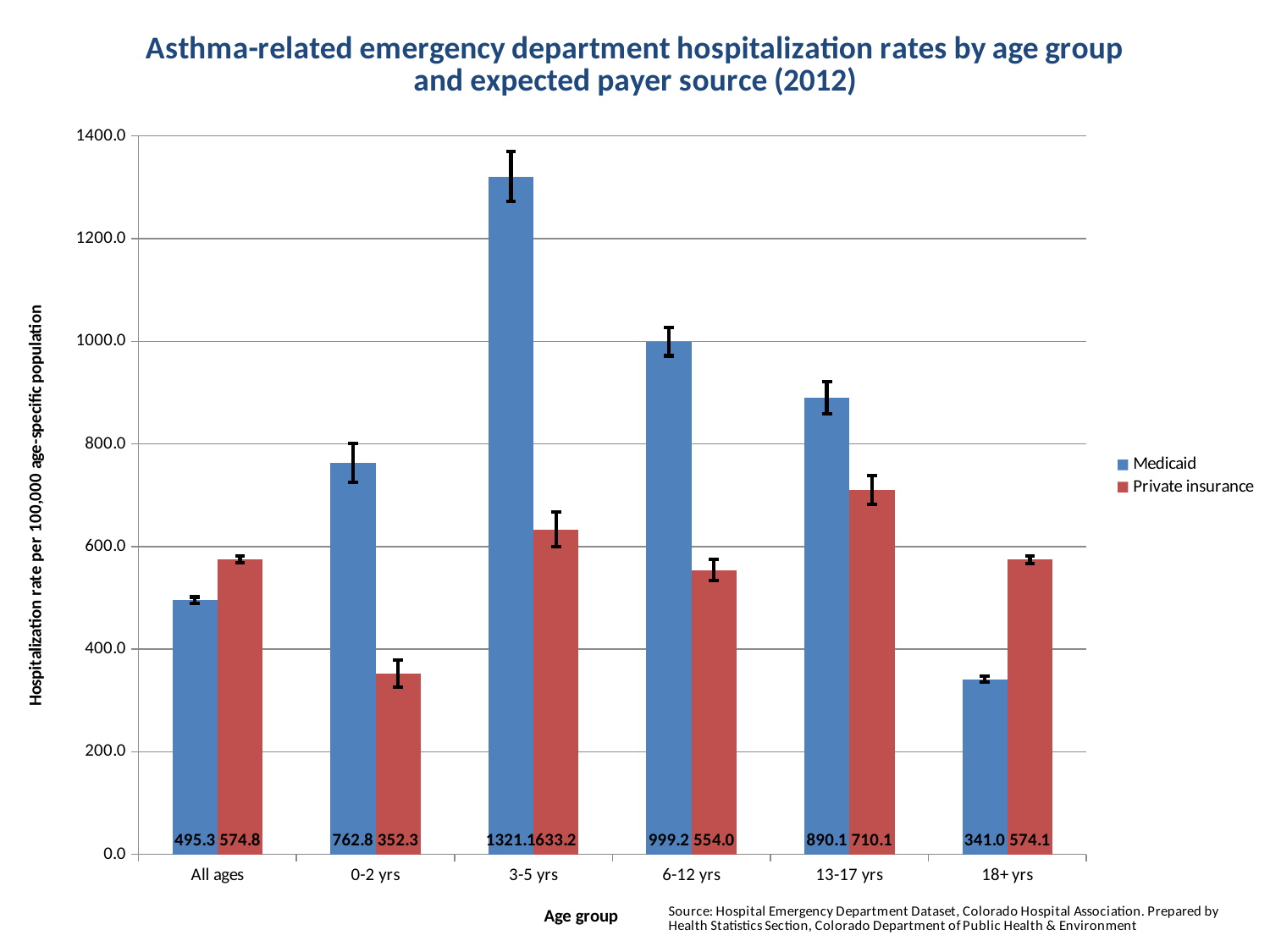
Is the Medicaid rate for the 13-17 yrs age group greater or less than 800.0? greater Which age group has the highest Medicaid hospitalization rate? 3-5 yrs What is the difference between the Medicaid and Private insurance rates for the 6-12 yrs age group? 445.2 For the All ages group, which is larger: the Medicaid rate or the Private insurance rate? Private insurance What is the Medicaid hospitalization rate for the 18+ yrs age group? 341.0 How many age groups are shown on the x axis? 6 How many series does the legend list? 2 What is the Medicaid hospitalization rate for the 3-5 yrs age group? 1321.1 What kind of chart is shown on the slide? Bar chart What is the label of the y axis? Hospitalization rate per 100,000 age-specific population Which age group has the lowest Private insurance hospitalization rate? 0-2 yrs What is the Private insurance hospitalization rate for the 0-2 yrs age group? 352.3